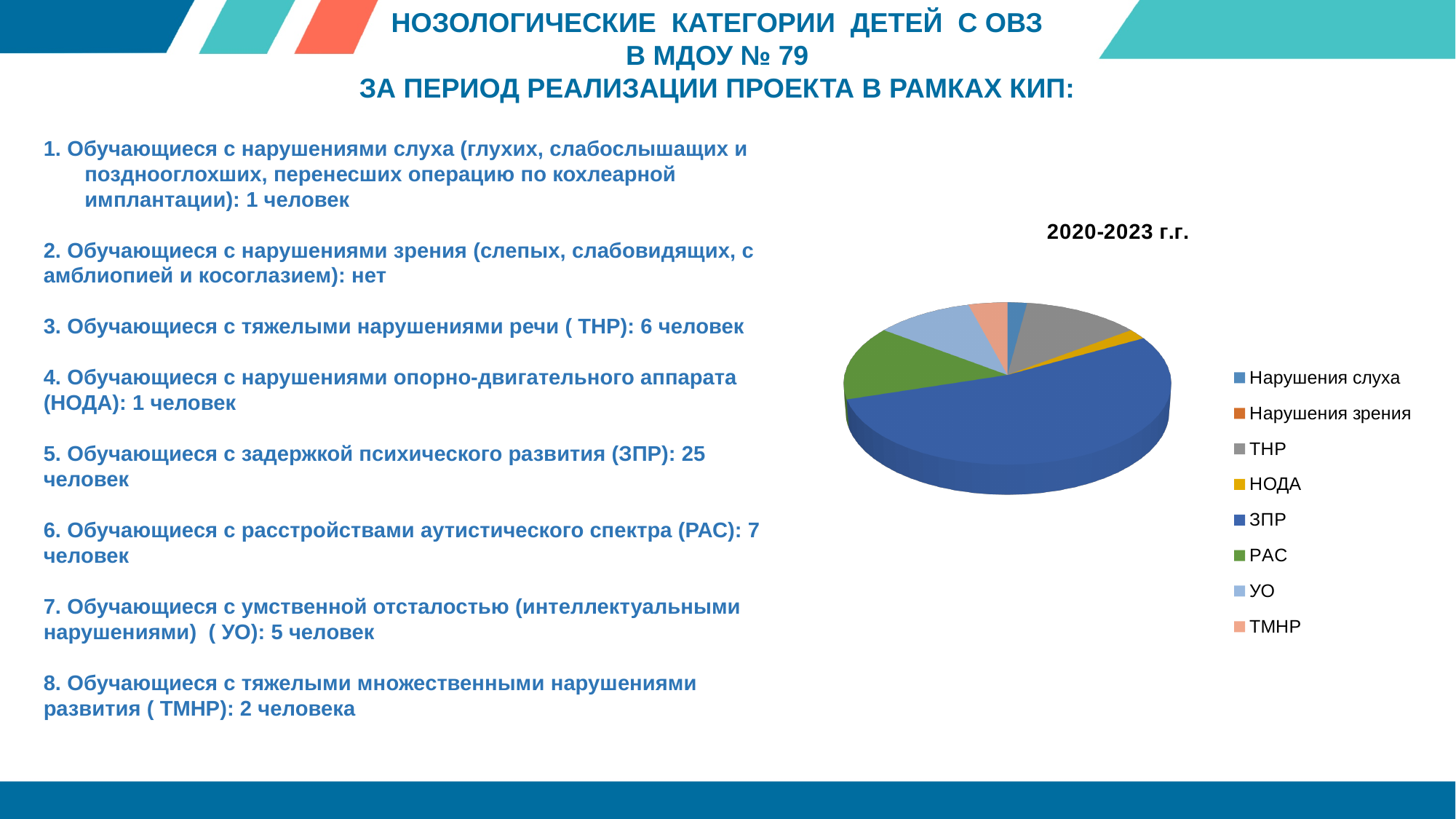
What is the title of the pie chart? 2020-2023 г.г. What kind of chart is shown on the slide? pie chart According to the slide text, how many children with РАС are there? 7 человек Which slice is larger in the pie chart, ЗПР or УО? ЗПР According to the slide text, how many children with ЗПР are there? 25 человек Which slice is larger in the pie chart, ТНР or ТМНР? ТНР How many categories does the legend of the pie chart list? 8 According to the slide text, how many children with ТМНР are there? 2 человека According to the slide text, how many children with ТНР are there? 6 человек Which category is shown in green in the pie chart? РАС Which category has the largest slice in the pie chart? ЗПР Which slice is larger in the pie chart, ЗПР or РАС? ЗПР